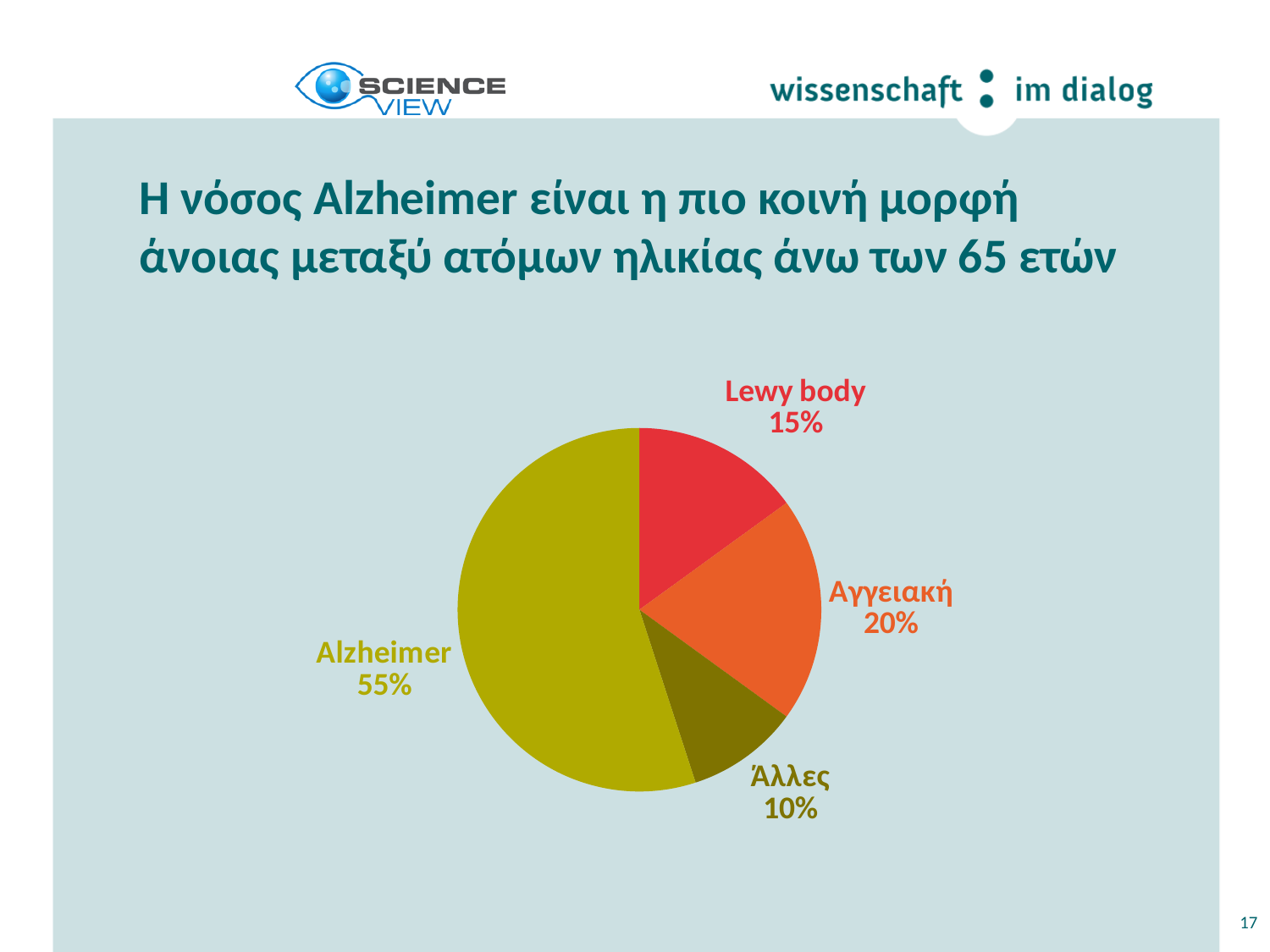
What percentage of the pie is labelled Alzheimer? 55% What percentage of the pie is labelled Άλλες? 10% What percentage of the pie is labelled Lewy body? 15% What is the combined share of the Αγγειακή and Lewy body slices? 35% Which is larger, the Lewy body slice or the Άλλες slice? Lewy body How many slices does the pie chart have? 4 What is the difference in percentage points between the Alzheimer slice and the Αγγειακή slice? 35 What colour is the Alzheimer slice of the pie? olive green What kind of chart is shown on the slide? pie chart Which slice of the pie is the largest? Alzheimer What percentage of the pie is labelled Αγγειακή? 20% Which slice of the pie is the smallest? Άλλες